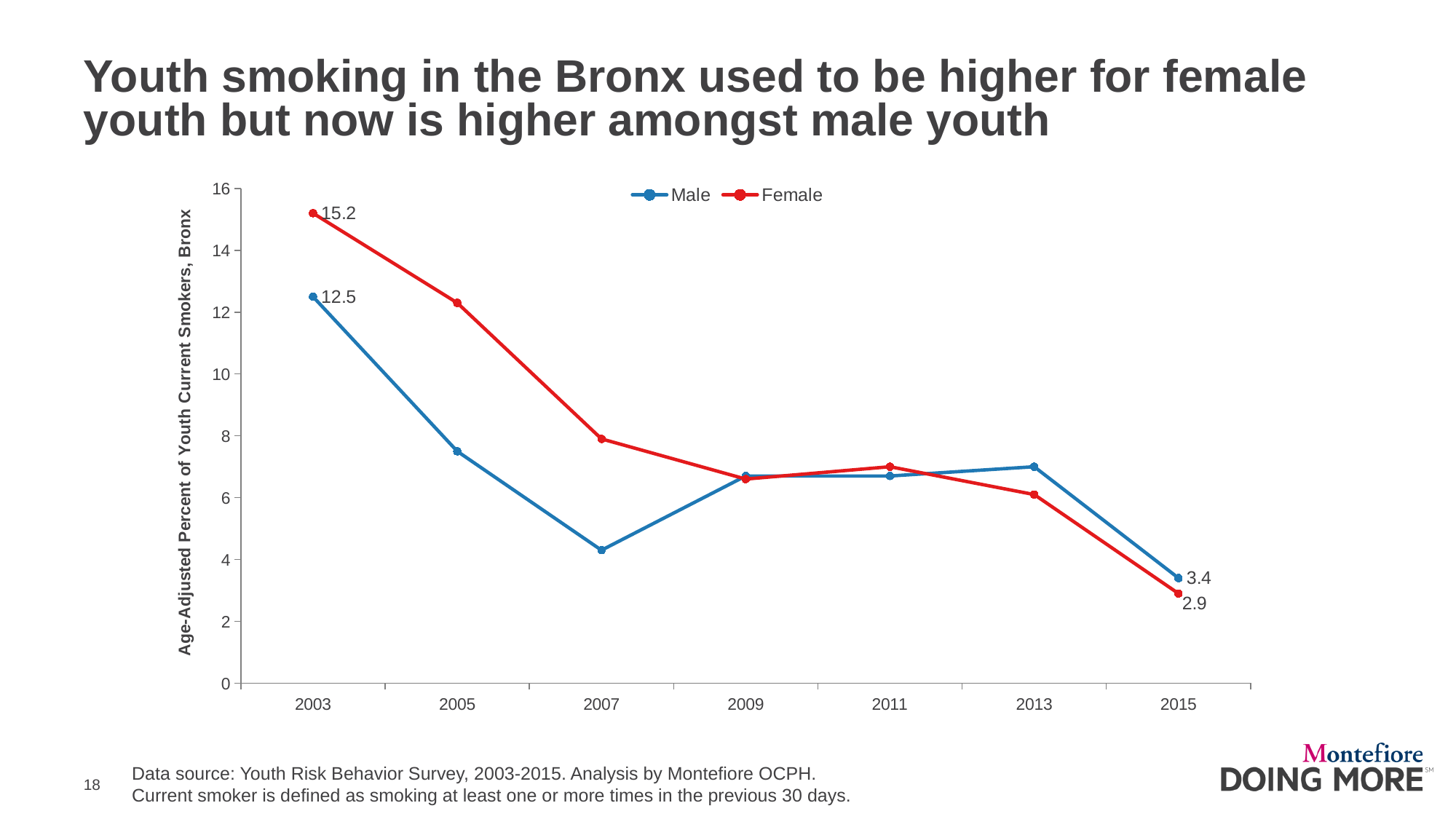
How much higher is the Female value than the Male value in 2003? 2.7 How much higher is the Male value than the Female value in 2015? 0.5 What is the value for Male in 2003? 12.5 What is the value for Female in 2003? 15.2 In 2015, which series has the higher value, Male or Female? Male What is the value for Female in 2015? 2.9 Is the value for Female in 2005 greater or less than 10? greater What is the value for Male in 2015? 3.4 Is the value for Male in 2007 greater or less than 6? less How many series does the legend list? 2 How many years are shown on the x axis? 7 In 2003, which series has the higher value, Male or Female? Female